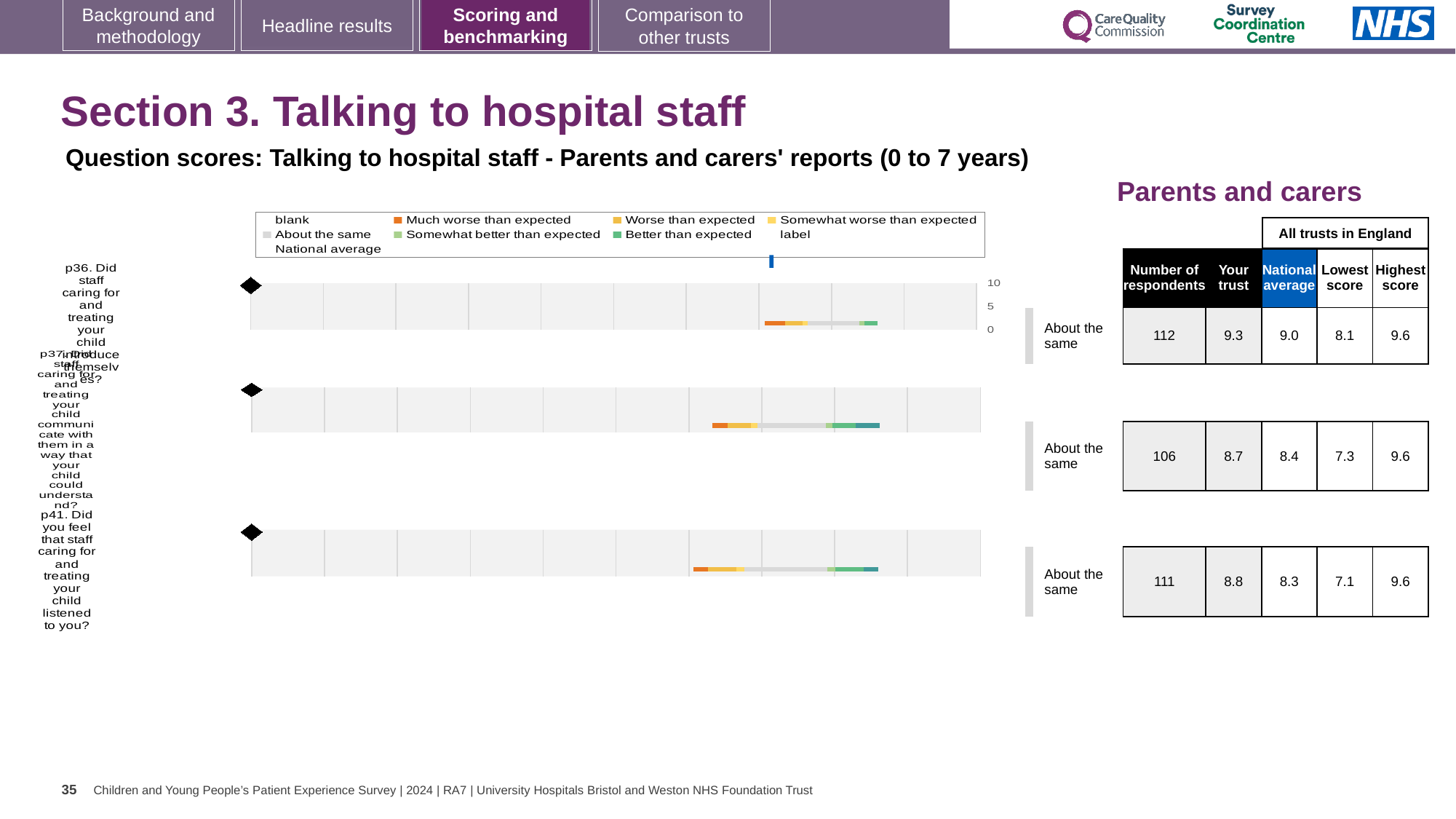
In the table next to the p36 chart, what is the 'Your trust' score? 9.3 For p41, what is the difference between the 'Your trust' score (8.8) and the National average (8.3)? 0.5 What benchmark category is shown beside the p37 chart? About the same Which legend entry is shown in orange? Much worse than expected What kind of chart is used to show the p36 question score? bar chart In the table next to the p37 chart, what is the Number of respondents? 106 For p36, which is larger: the 'Your trust' score or the National average? Your trust What is the highest value shown on the chart axis? 10 Which question has the highest 'Your trust' score in the table? p36 How many question charts are plotted on the slide? 3 In the table next to the p37 chart, what is the National average score? 8.4 In the table next to the p41 chart, what is the Lowest score? 7.1